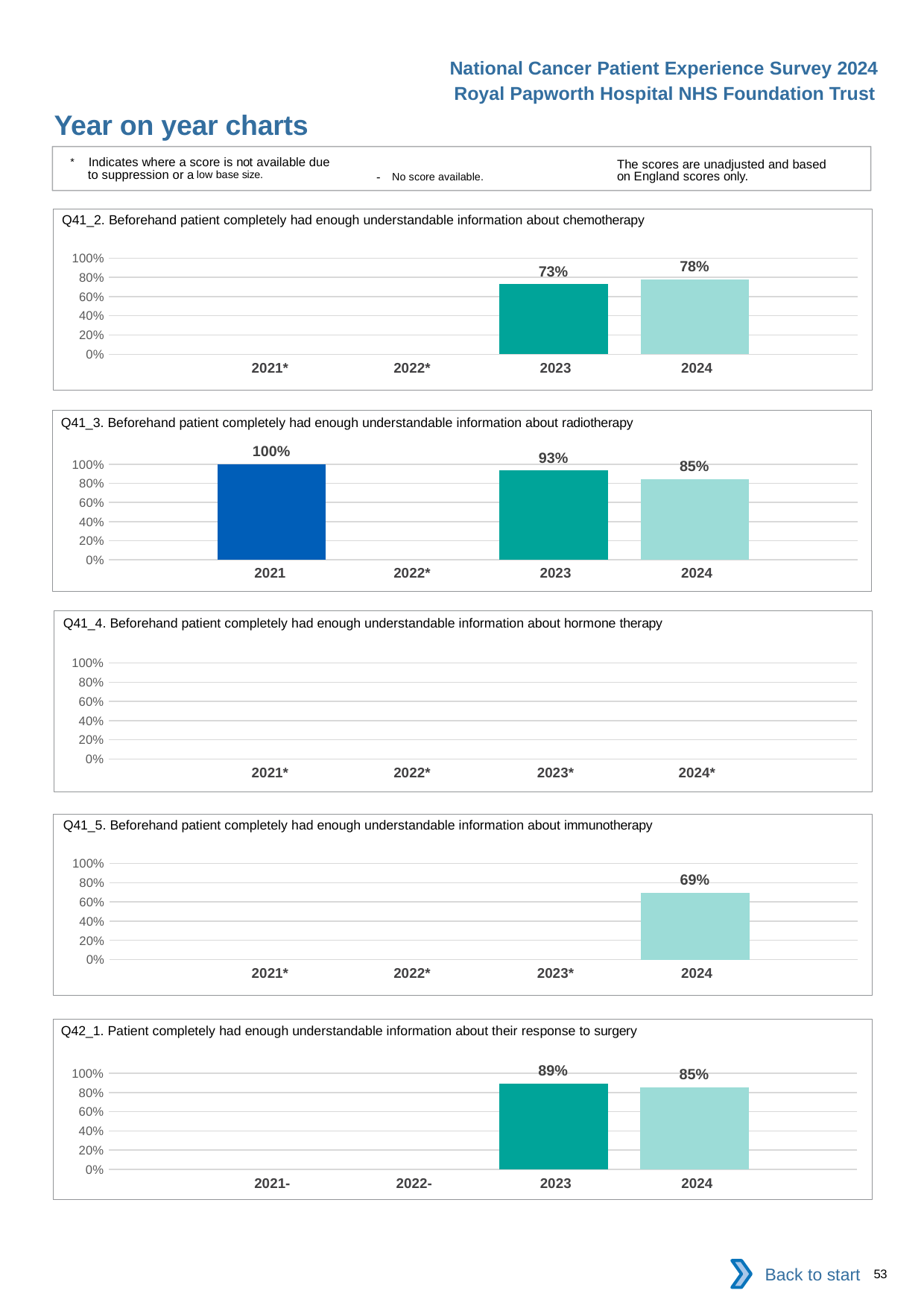
In the Q41_3 radiotherapy chart, what is the value for 2021? 100% In the Q41_3 radiotherapy chart, which year has the lowest plotted value? 2024 In the Q42_1 response to surgery chart, what is the value for 2023? 89% In the Q41_3 radiotherapy chart, do the plotted values rise or fall from 2021 to 2024? fall In the Q41_5 immunotherapy chart, is the value for 2024 greater or less than 60%? greater In the Q42_1 response to surgery chart, which is larger, the 2023 value or the 2024 value? 2023 In the Q41_5 immunotherapy chart, what is the value for 2024? 69% In the Q41_2 chemotherapy chart, what is the value for 2024? 78% What type of chart is the Q41_2 chemotherapy chart? bar chart In the Q42_1 response to surgery chart, what is the difference between the 2023 and 2024 values? 4% In the Q41_2 chemotherapy chart, what is the difference between the 2024 and 2023 values? 5% In the Q41_4 hormone therapy chart, how many bars are plotted? 0